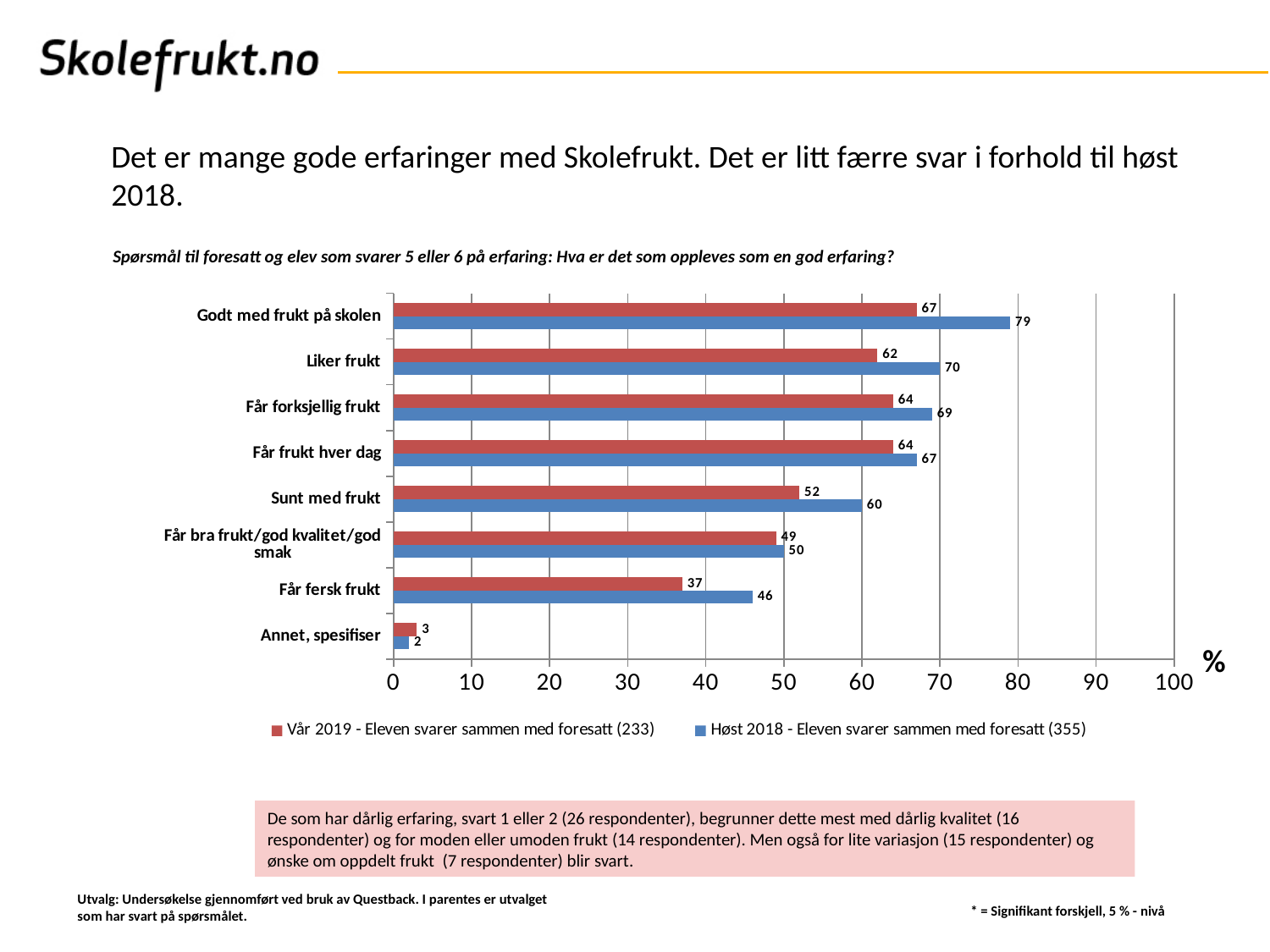
Which colour represents the Høst 2018 series in the chart? Blue What is the value for "Får bra frukt/god kvalitet/god smak" in the Vår 2019 series? 49 How many series does the legend list? 2 Which category has the highest value in the Høst 2018 series? Godt med frukt på skolen Which category has the lowest value in the Vår 2019 series? Annet, spesifiser What is the value for "Sunt med frukt" in the Høst 2018 series? 60 What is the difference between the Høst 2018 and Vår 2019 values for "Godt med frukt på skolen"? 12 How many categories are shown on the chart? 8 Which is larger for "Liker frukt": the Vår 2019 value or the Høst 2018 value? Høst 2018 What is the value for "Får fersk frukt" in the Vår 2019 series? 37 What kind of chart is shown on the slide? Bar chart What is the value for "Godt med frukt på skolen" in the Høst 2018 series? 79